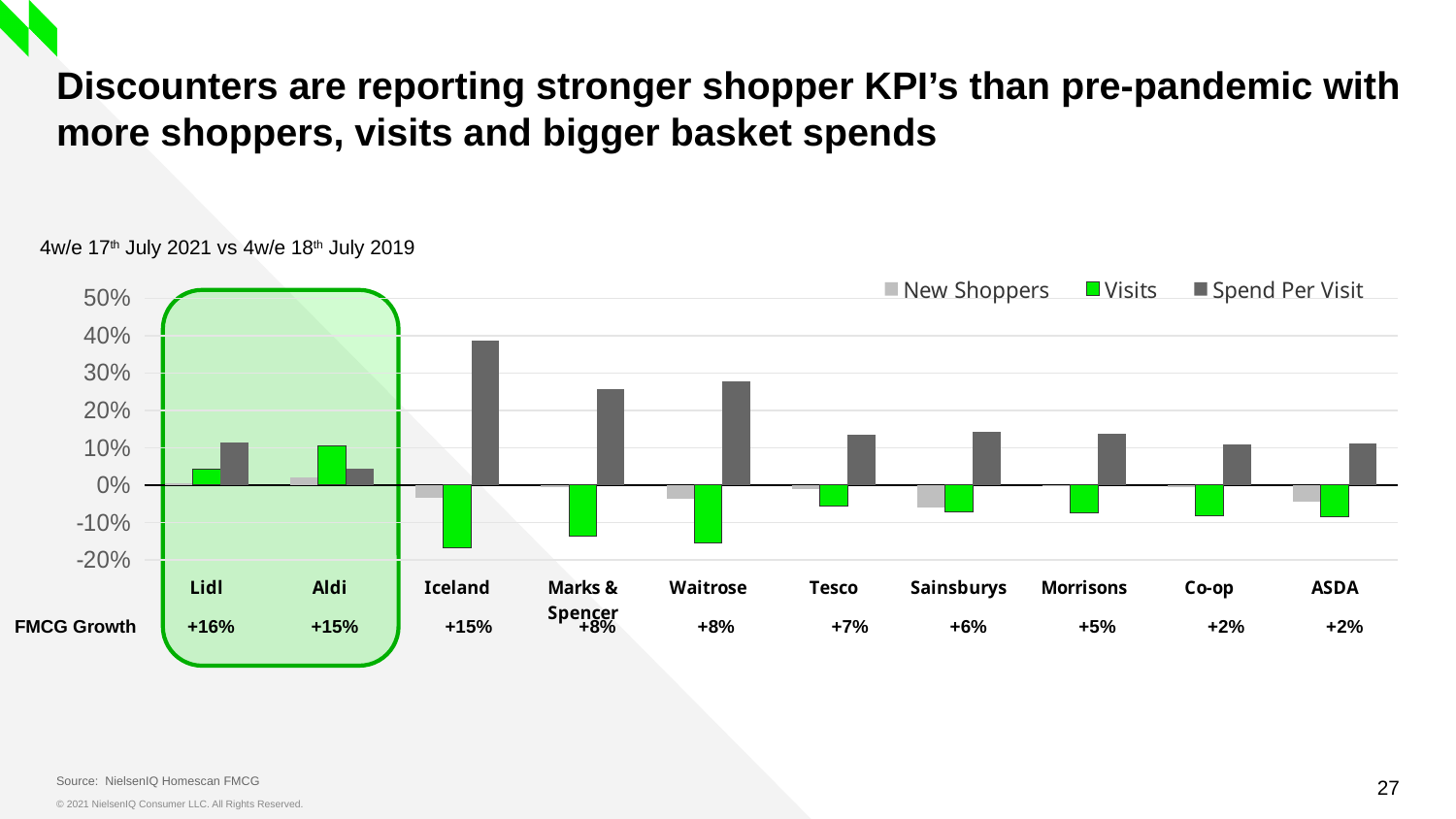
Is the Spend Per Visit value for Waitrose greater or less than 20%? greater Which retailer has the highest Spend Per Visit value in the chart? Iceland How many series does the chart legend list? 3 What kind of chart is shown on the slide? bar chart What FMCG Growth figure is shown for Lidl below the chart? +16% Which is larger, the Visits value for Lidl or the Visits value for Tesco? Lidl How many retailers are shown along the x axis of the chart? 10 Which is larger, the Spend Per Visit value for Iceland or the Spend Per Visit value for Tesco? Iceland Is the Visits value for Lidl greater or less than 10%? less Is the Spend Per Visit value for Iceland greater or less than 30%? greater Which series in the legend is shown in green? Visits